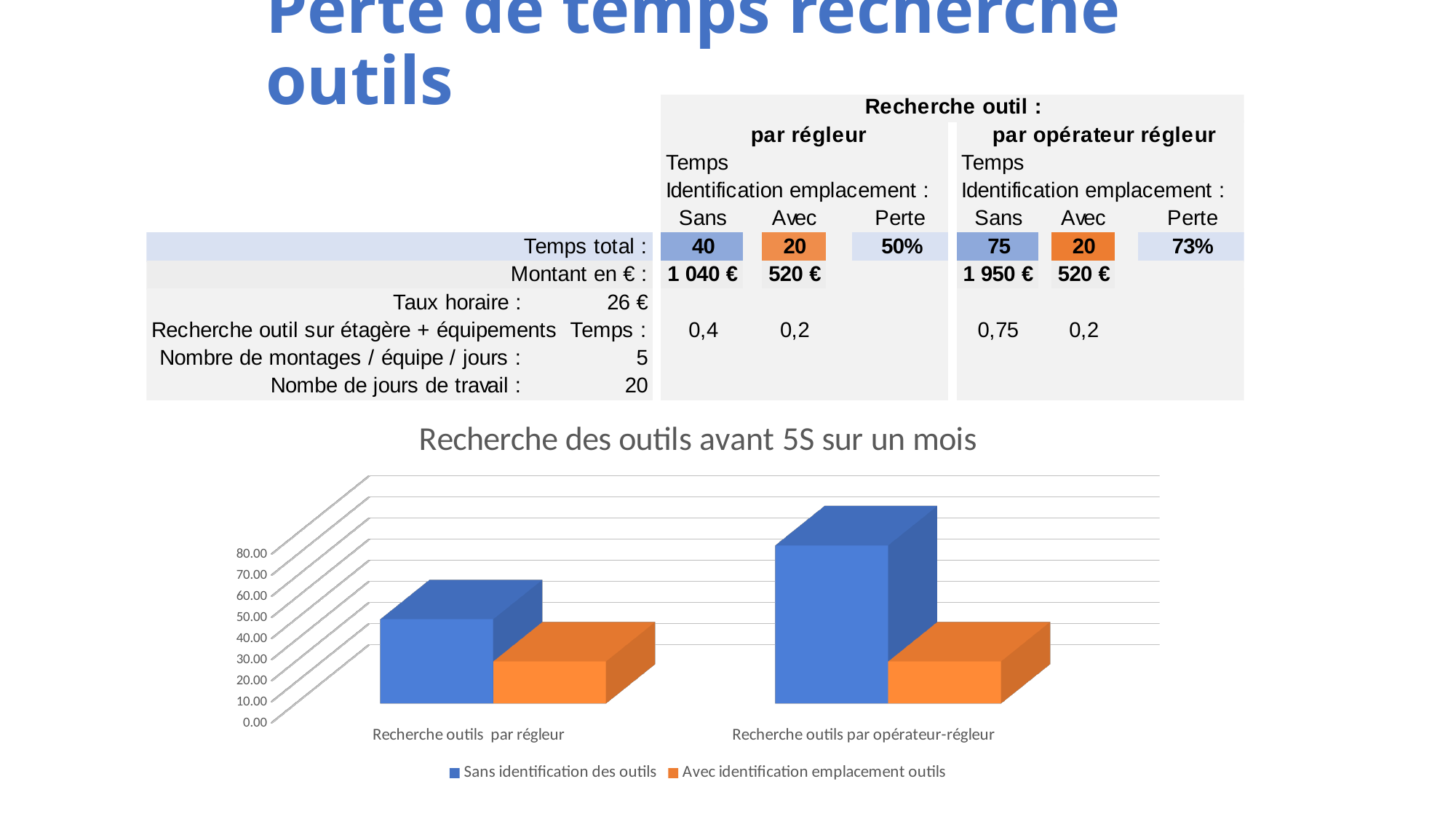
Is the 'Sans identification des outils' value for 'Recherche outils par régleur' greater or less than 60? less Which category has the highest bar in the chart? Recherche outils par opérateur-régleur Which colour represents the series 'Sans identification des outils' in the chart? blue Which series has the larger 'Sans identification des outils' bar: 'Recherche outils par régleur' or 'Recherche outils par opérateur-régleur'? Recherche outils par opérateur-régleur What kind of chart is shown on the slide? bar chart For 'Recherche outils par régleur', which is larger: 'Sans identification des outils' or 'Avec identification emplacement outils'? Sans identification des outils How many series does the chart legend list? 2 Is the 'Avec identification emplacement outils' value for 'Recherche outils par régleur' greater or less than 40? less For 'Recherche outils par opérateur-régleur', which is larger: 'Sans identification des outils' or 'Avec identification emplacement outils'? Sans identification des outils Is the 'Sans identification des outils' value for 'Recherche outils par opérateur-régleur' greater or less than 60? greater What is the title of the chart? Recherche des outils avant 5S sur un mois How many categories are shown on the x axis of the chart? 2